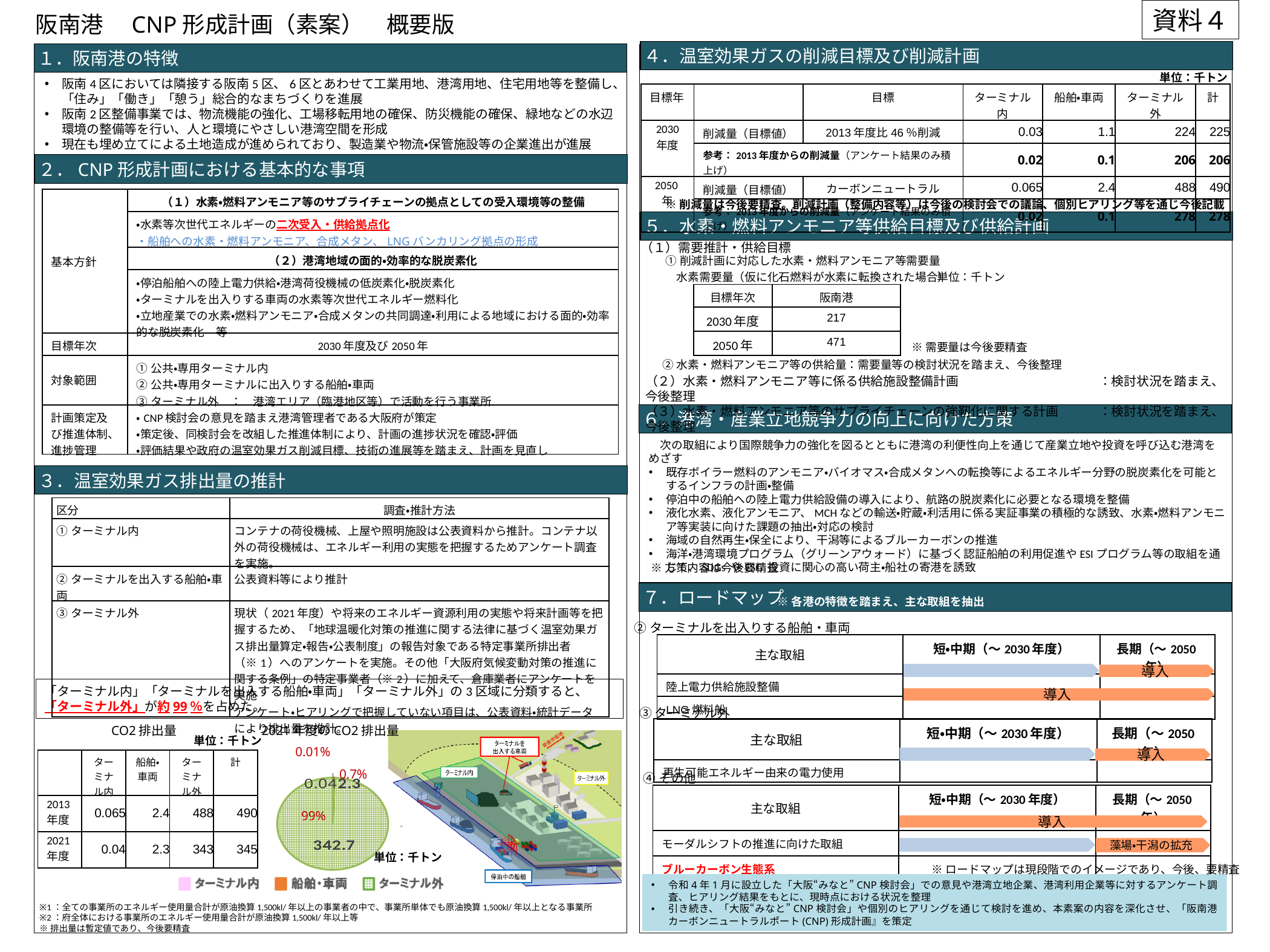
In the 2021年度のCO2排出量 pie chart, what is the value for 船舶・車両? 2.3 In the 2021年度のCO2排出量 pie chart, what is the value for ターミナル外? 342.7 What kind of chart is used to show the 2021年度のCO2排出量? pie chart Which category has the smallest slice in the 2021年度のCO2排出量 pie chart? ターミナル内 What unit is stated for the values in the 2021年度のCO2排出量 pie chart? 千トン In the 2021年度のCO2排出量 pie chart, what is the difference between the values for ターミナル外 and 船舶・車両? 340.4 In the 2021年度のCO2排出量 pie chart, what is the value for ターミナル内? 0.04 How many categories does the legend of the 2021年度のCO2排出量 pie chart list? 3 In the 2021年度のCO2排出量 pie chart, what share of the total does 船舶・車両 account for? 0.7% In the 2021年度のCO2排出量 pie chart, what share of the total does ターミナル内 account for? 0.01% In the 2021年度のCO2排出量 pie chart, what share of the total does ターミナル外 account for? 99% Which category has the largest slice in the 2021年度のCO2排出量 pie chart? ターミナル外